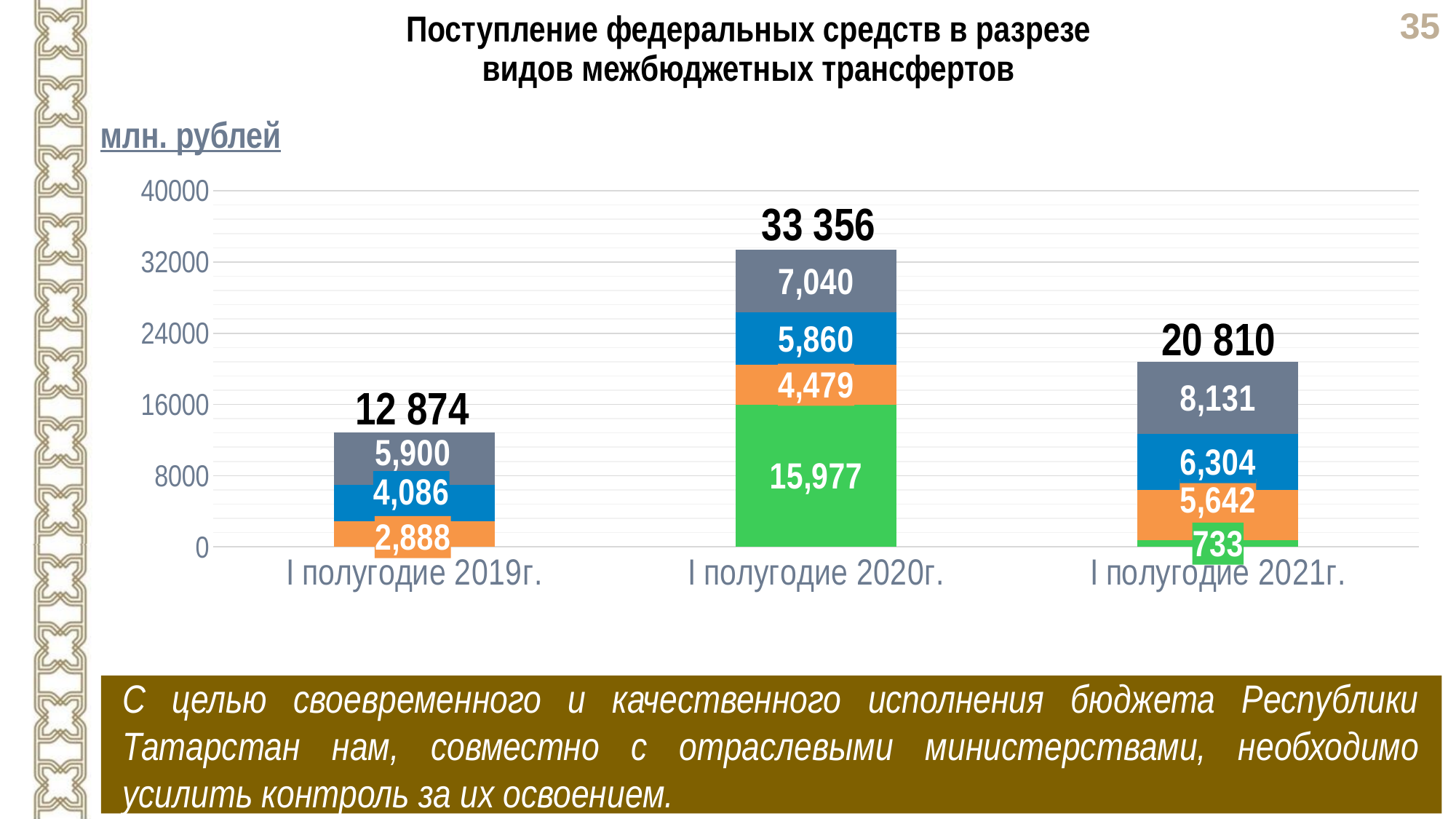
Is the total for I полугодие 2019г. greater or less than 16000? less What is the difference between the total for I полугодие 2020г. and the total for I полугодие 2021г.? 12 546 Which is larger: the blue segment for I полугодие 2021г. or the blue segment for I полугодие 2020г.? I полугодие 2021г. What is the value of the green segment in the bar for I полугодие 2020г.? 15,977 What is the value of the orange segment in the bar for I полугодие 2019г.? 2,888 Which period has the lowest total value? I полугодие 2019г. What is the value of the green segment in the bar for I полугодие 2021г.? 733 What is the total value of the stacked bar for I полугодие 2020г.? 33 356 What kind of chart is shown on the slide? stacked bar chart What is the total value of the stacked bar for I полугодие 2019г.? 12 874 Which period has the highest total value? I полугодие 2020г. What is the value of the grey segment in the bar for I полугодие 2021г.? 8,131